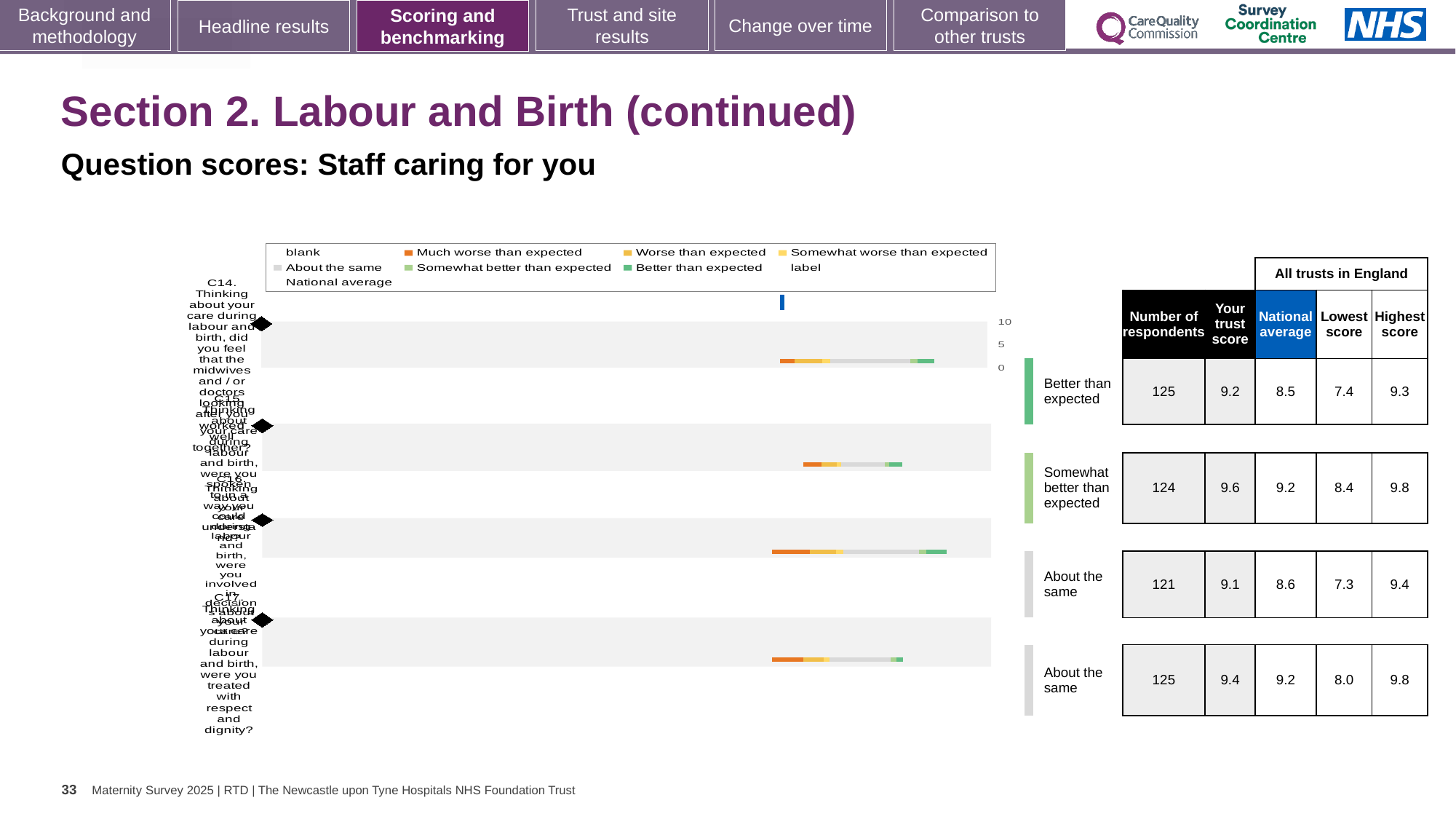
How many entries does the chart legend list? 9 For the row rated 'Somewhat better than expected', which is larger: the trust score or the national average? trust score Which row in the table has the highest trust score? Somewhat better than expected In the table next to the chart, what is the highest score for the row rated 'Somewhat better than expected'? 9.8 In the table next to the chart, what is the lowest score for the row rated 'Better than expected'? 7.4 In the table next to the chart, what is the trust score for the row rated 'Somewhat better than expected'? 9.6 What kind of chart is shown on the slide? bar chart In the table next to the chart, what is the national average for the row rated 'Better than expected'? 8.5 What is the highest value shown on the chart's axis? 10 For the row rated 'Better than expected', what is the difference between the trust score and the national average? 0.7 In the table next to the chart, what is the number of respondents for the row rated 'Better than expected'? 125 How many question rows (bars) does the chart show? 4